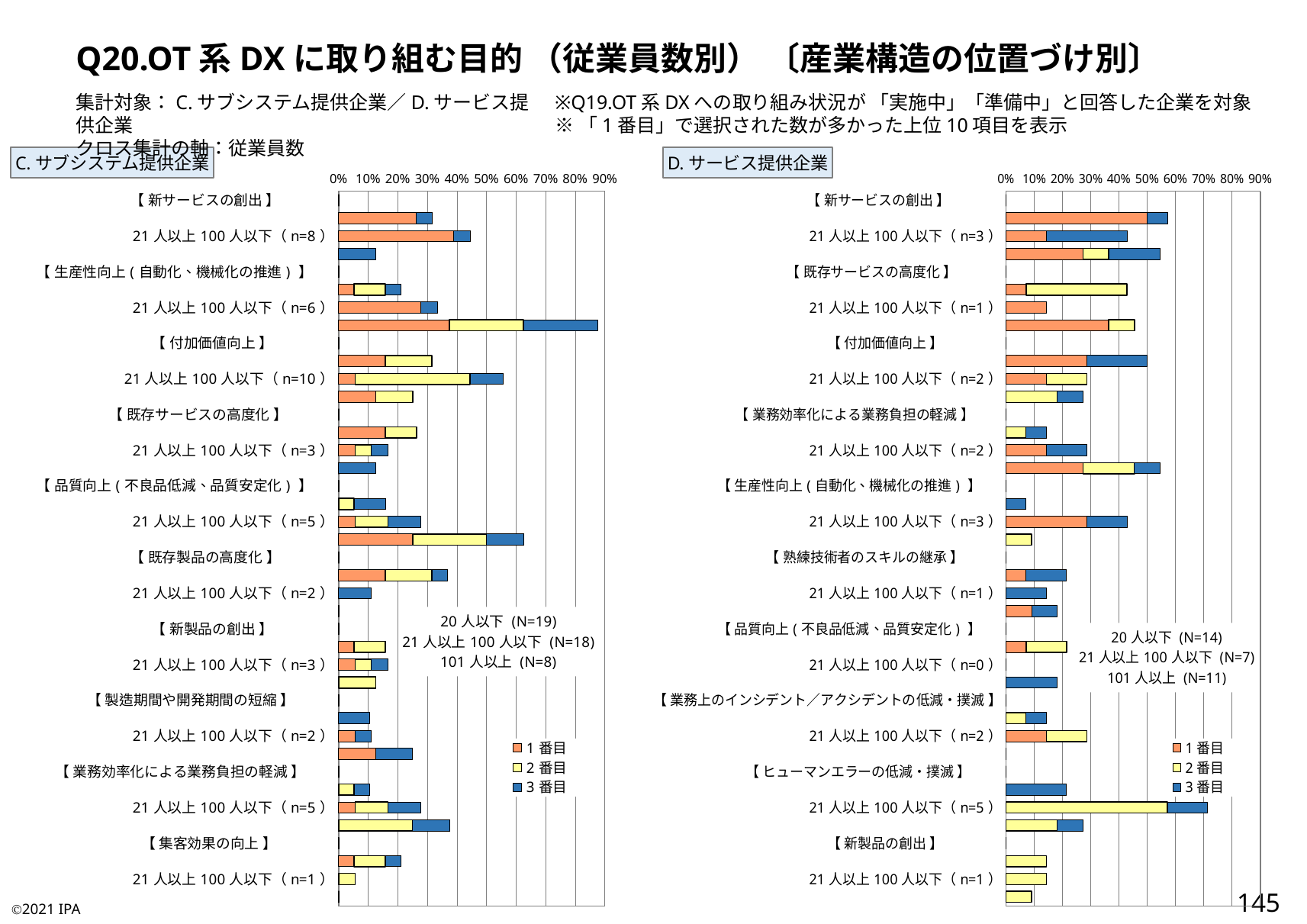
How many series does the legend of the right chart (D. サービス提供企業) list? 3 How many purpose categories (bracketed headings) are shown in the right chart (D. サービス提供企業)? 10 In the right chart (D. サービス提供企業), is the total of the 20人以下 bar for 新サービスの創出 greater or less than 50%? greater In the right chart (D. サービス提供企業), is the total of the 21人以上100人以下 bar for ヒューマンエラーの低減・撲滅 greater or less than 60%? greater What is the highest percentage tick shown on the x axis of the left chart (C. サブシステム提供企業)? 90% In the left chart (C. サブシステム提供企業), is the total of the 20人以下 bar for 新サービスの創出 greater or less than 40%? less In the right chart (D. サービス提供企業), for 生産性向上(自動化、機械化の推進), which bar is longer: the 20人以下 bar or the 21人以上100人以下 bar? 21人以上100人以下 What kind of chart is the left chart titled C. サブシステム提供企業? Stacked horizontal bar chart What is the N for 20人以下 shown in the note on the right chart (D. サービス提供企業)? N=14 In the left chart (C. サブシステム提供企業), for 付加価値向上, which bar is longer: the 20人以下 bar or the 21人以上100人以下 bar? 21人以上100人以下 What are the legend entries of the left chart (C. サブシステム提供企業)? 1番目, 2番目, 3番目